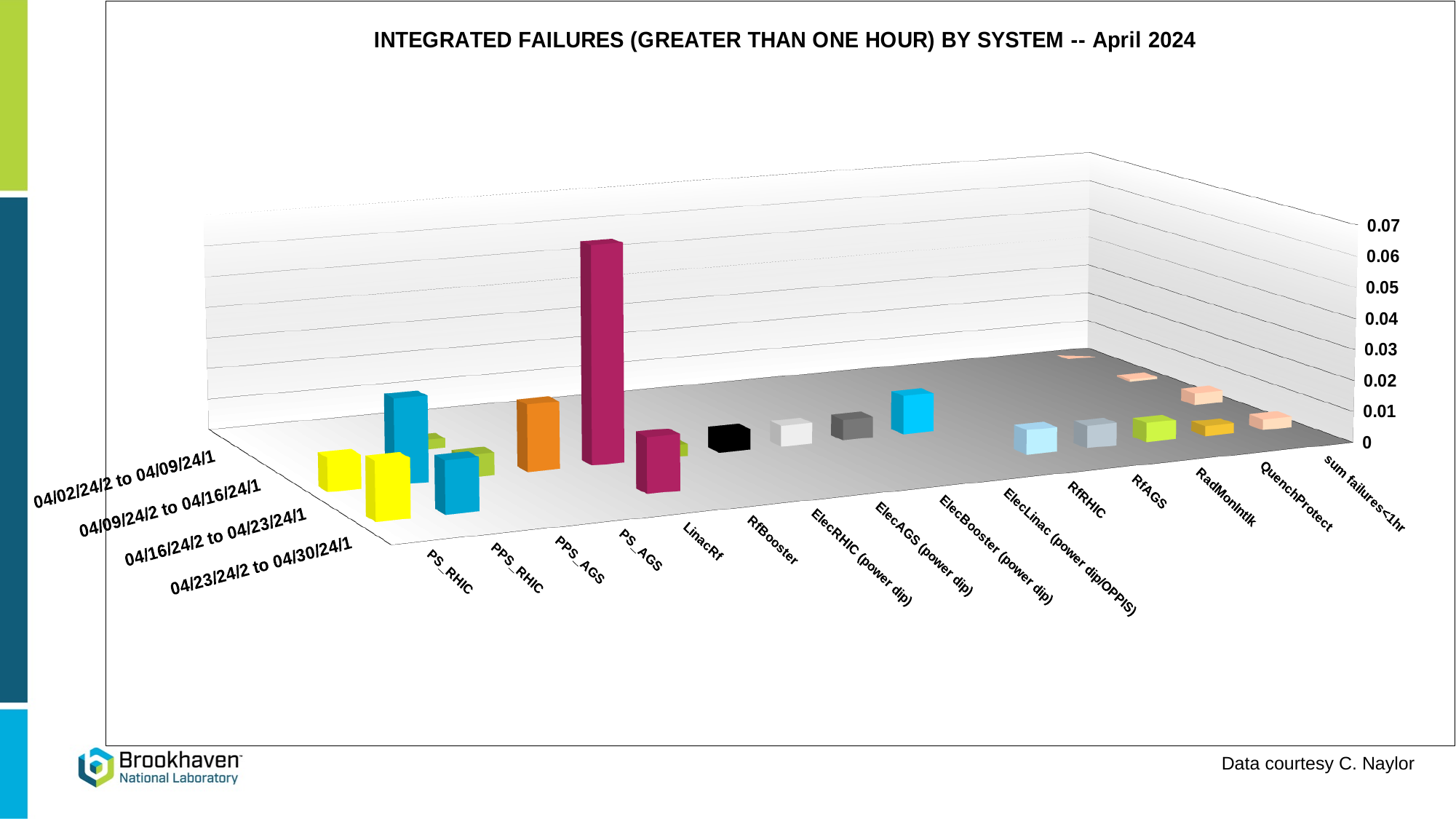
What is the label of the first weekly period on the depth axis? 04/02/24/2 to 04/09/24/1 How many systems are listed along the horizontal axis of the chart? 15 Which system has the tallest bar in the chart? LinacRf What kind of chart is shown on the slide? 3D bar chart What is the label of the last system on the horizontal axis? sum failures<1hr Are the bars for PS_RHIC greater or less than 0.03? less Which is larger, the tallest bar for PS_AGS or the tallest bar for PPS_AGS? PS_AGS What is the highest value shown on the vertical axis of the chart? 0.07 What is the title of the chart? INTEGRATED FAILURES (GREATER THAN ONE HOUR) BY SYSTEM -- April 2024 How many weekly periods are listed along the depth axis of the chart? 4